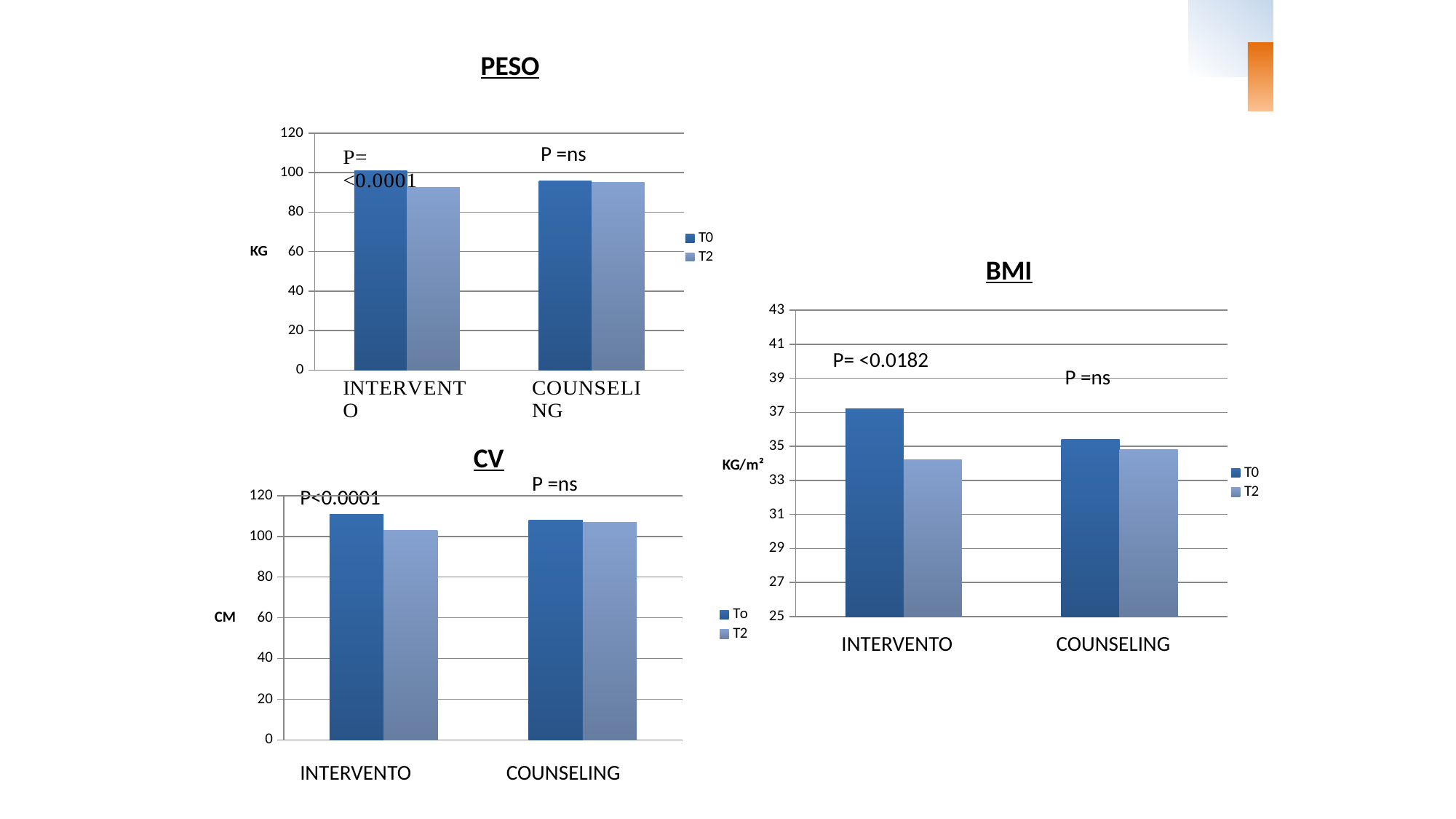
In the PESO chart, is the T2 value for INTERVENTO greater or less than 100? less In the BMI chart, is the T0 value for INTERVENTO greater or less than 35? greater How many series does the legend of the BMI chart list? 2 In the CV chart, is the T0 value for INTERVENTO greater or less than 100? greater What is the y-axis unit label on the BMI chart? KG/m² In the BMI chart, which bar is the highest? INTERVENTO T0 In the PESO chart, which is larger for INTERVENTO, T0 or T2? T0 What kind of chart is the PESO chart? bar chart What is the y-axis unit label on the CV chart? CM How many categories are shown on the x axis of the CV chart? 2